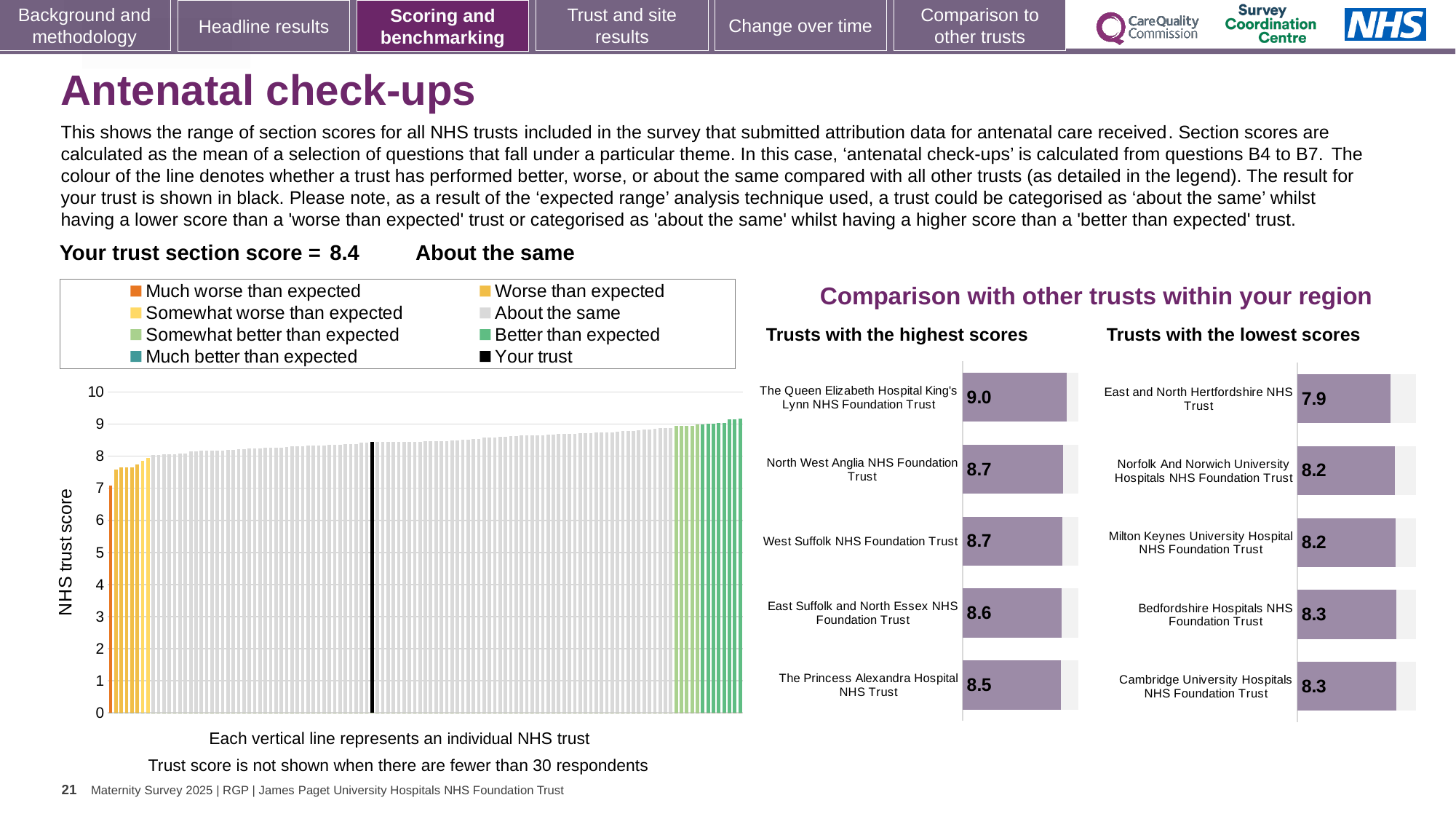
In the 'Trusts with the highest scores' chart, which trust has the highest score? The Queen Elizabeth Hospital King's Lynn NHS Foundation Trust In the 'Trusts with the highest scores' chart, what is the score for The Princess Alexandra Hospital NHS Trust? 8.5 In the main 'NHS trust score' chart on the left, is the value for the black 'Your trust' bar greater or less than 8? greater What is the difference between the score of The Queen Elizabeth Hospital King's Lynn NHS Foundation Trust in the highest scores chart and East and North Hertfordshire NHS Trust in the lowest scores chart? 1.1 What kind of chart is the main 'NHS trust score' chart on the left? Bar chart In the 'Trusts with the lowest scores' chart, what is the score for East and North Hertfordshire NHS Trust? 7.9 In the 'Trusts with the highest scores' chart, what is the score for The Queen Elizabeth Hospital King's Lynn NHS Foundation Trust? 9.0 How many entries does the legend of the main 'NHS trust score' chart list? 8 How many trusts are shown in the 'Trusts with the lowest scores' chart? 5 In the 'Trusts with the lowest scores' chart, which trust has the lowest score? East and North Hertfordshire NHS Trust In the 'Trusts with the highest scores' chart, which has the larger score: East Suffolk and North Essex NHS Foundation Trust or The Princess Alexandra Hospital NHS Trust? East Suffolk and North Essex NHS Foundation Trust In the 'Trusts with the lowest scores' chart, what is the score for Bedfordshire Hospitals NHS Foundation Trust? 8.3